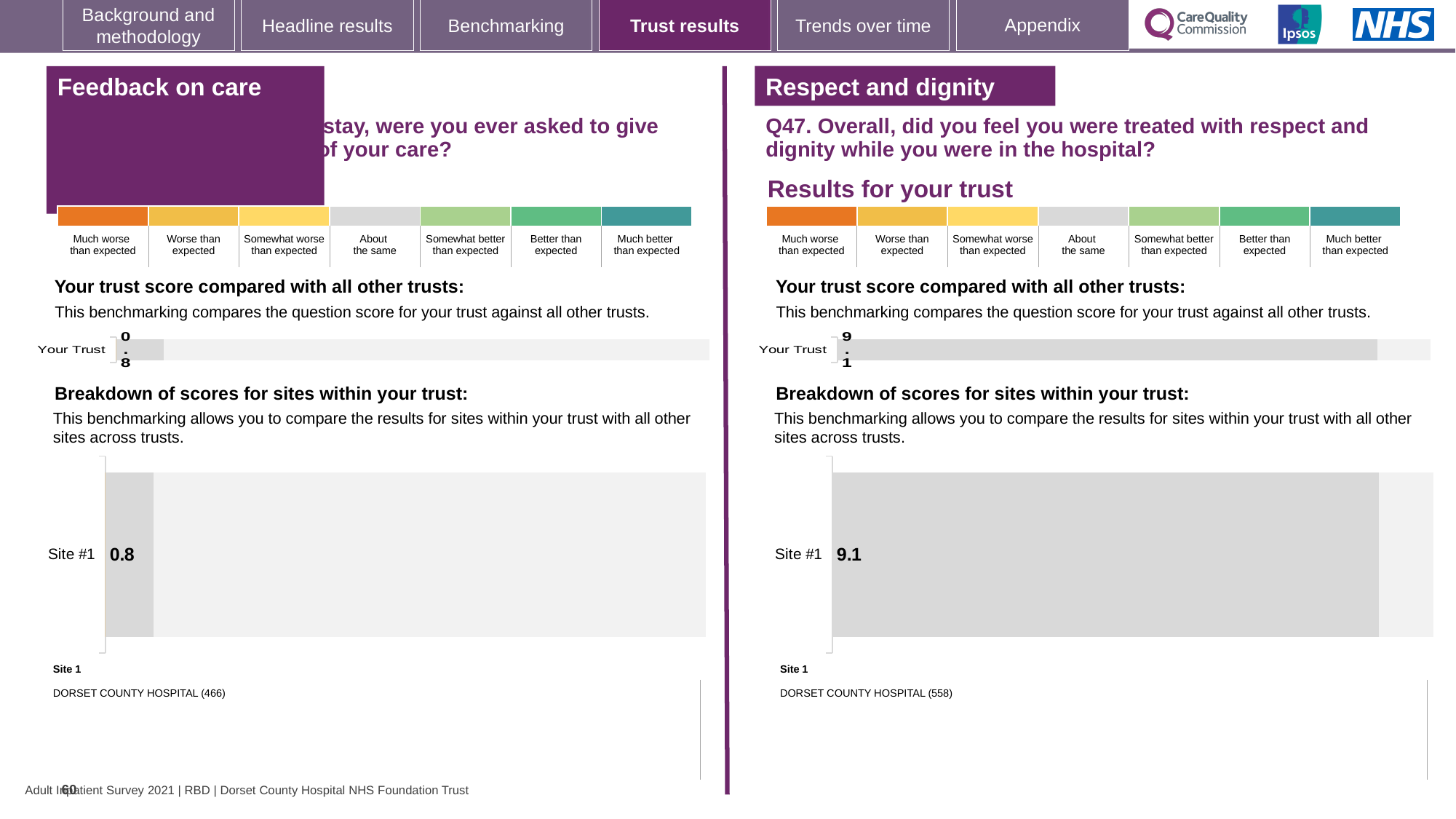
How many sites are shown in the 'Breakdown of scores for sites within your trust' chart on the right (Respect and dignity)? 1 In the 'Breakdown of scores for sites within your trust' chart on the right (Respect and dignity), what is the value for Site #1? 9.1 How many sites are shown in the 'Breakdown of scores for sites within your trust' chart on the left (Feedback on care)? 1 What kind of chart is used to show the Site #1 score in the 'Breakdown of scores for sites within your trust' section on the left? Bar chart On the 'Respect and dignity' section, what is the score shown for Your Trust? 9.1 Is the Your Trust score for Respect and dignity greater or less than the Your Trust score for Feedback on care? greater What is the difference between the Site #1 score for Respect and dignity and the Site #1 score for Feedback on care? 8.3 Which site is listed as Site 1 under the Respect and dignity breakdown chart? DORSET COUNTY HOSPITAL (558) On the 'Feedback on care' section, what is the score shown for Your Trust? 0.8 Which is larger: the Site #1 score for Feedback on care or the Site #1 score for Respect and dignity? Respect and dignity Which site is listed as Site 1 under the Feedback on care breakdown chart? DORSET COUNTY HOSPITAL (466) In the 'Breakdown of scores for sites within your trust' chart on the left (Feedback on care), what is the value for Site #1? 0.8